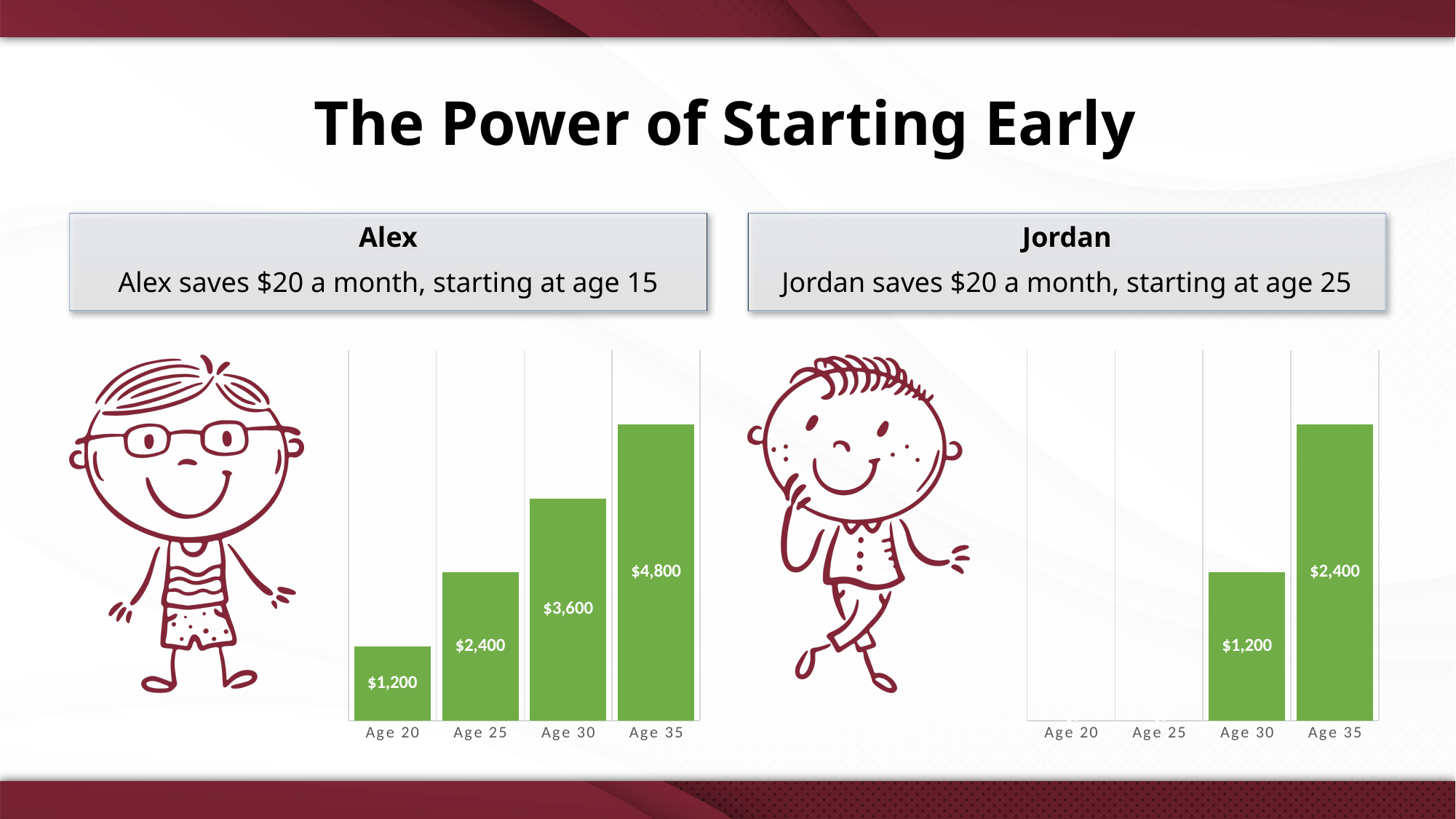
How many age categories are shown on the x axis of the Alex chart? 4 In the Jordan chart, what is the difference between the values for Age 35 and Age 30? $1,200 In the Alex chart, which age has the lowest value? Age 20 Which is larger: Alex's value at Age 35 or Jordan's value at Age 35? Alex's value at Age 35 In the Jordan chart, which age has the highest value? Age 35 In the Alex chart, what is the value for Age 20? $1,200 In the Alex chart, what is the difference between the values for Age 35 and Age 25? $2,400 In the Alex chart, do the values rise or fall from Age 20 to Age 35? Rise In the Alex chart, what is the value for Age 30? $3,600 In the Alex chart, which age has the highest value? Age 35 What kind of chart is the Jordan chart? Bar chart In the Jordan chart, what is the value for Age 35? $2,400